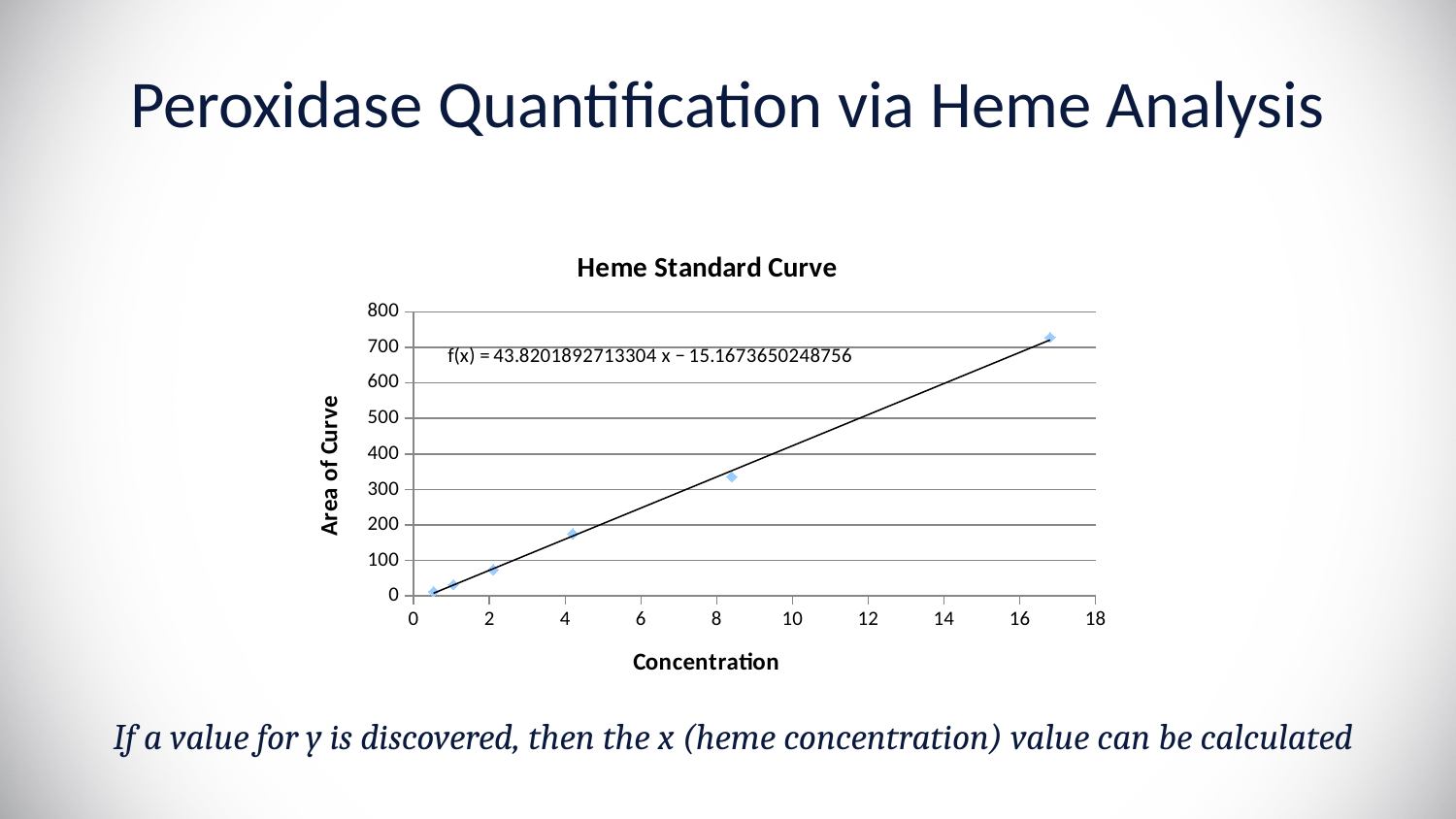
What is the maximum value shown on the y axis of the chart? 800 Which plotted point has the highest Area of Curve value: the one at a Concentration of about 8.4 or the one at about 16.8? The one at about 16.8 What is the label of the y axis? Area of Curve How many data points are plotted in the Heme Standard Curve chart? 6 Do the Area of Curve values rise or fall as Concentration increases? Rise What is the title of the chart? Heme Standard Curve Is the Area of Curve value for the point at a Concentration of about 2 greater or less than 100? less Is the Area of Curve value for the point at a Concentration of about 4.2 greater or less than 100? greater Is the Area of Curve value for the point at a Concentration of about 8.4 greater or less than 400? less What kind of chart is shown on the slide? Scatter chart